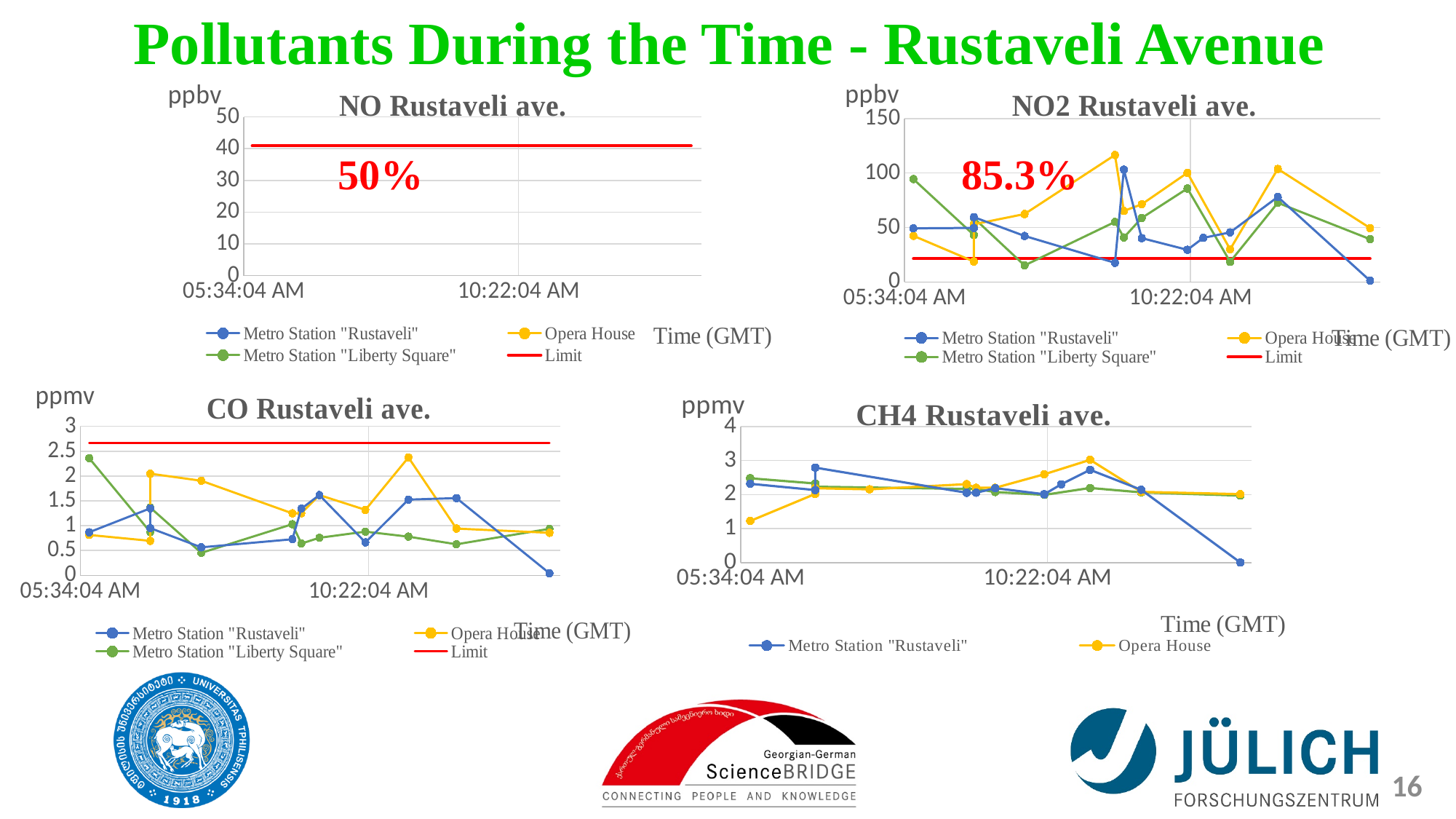
In the "CH4 Rustaveli ave." chart, is the first plotted value for Opera House greater or less than 2? less What percentage is printed in red on the "NO2 Rustaveli ave." chart? 85.3% How many entries does the legend of the "CO Rustaveli ave." chart list? 4 In the "CO Rustaveli ave." chart, is the first plotted value for Metro Station "Liberty Square" greater or less than 2? greater What kind of chart is the "NO2 Rustaveli ave." chart? line chart In the "NO2 Rustaveli ave." chart, which series reaches the highest value? Opera House How many series does the legend of the "CH4 Rustaveli ave." chart list? 2 What unit is shown on the vertical axis of the "CO Rustaveli ave." chart? ppmv In the "CO Rustaveli ave." chart, is the Limit line greater or less than 2.5 ppmv? greater